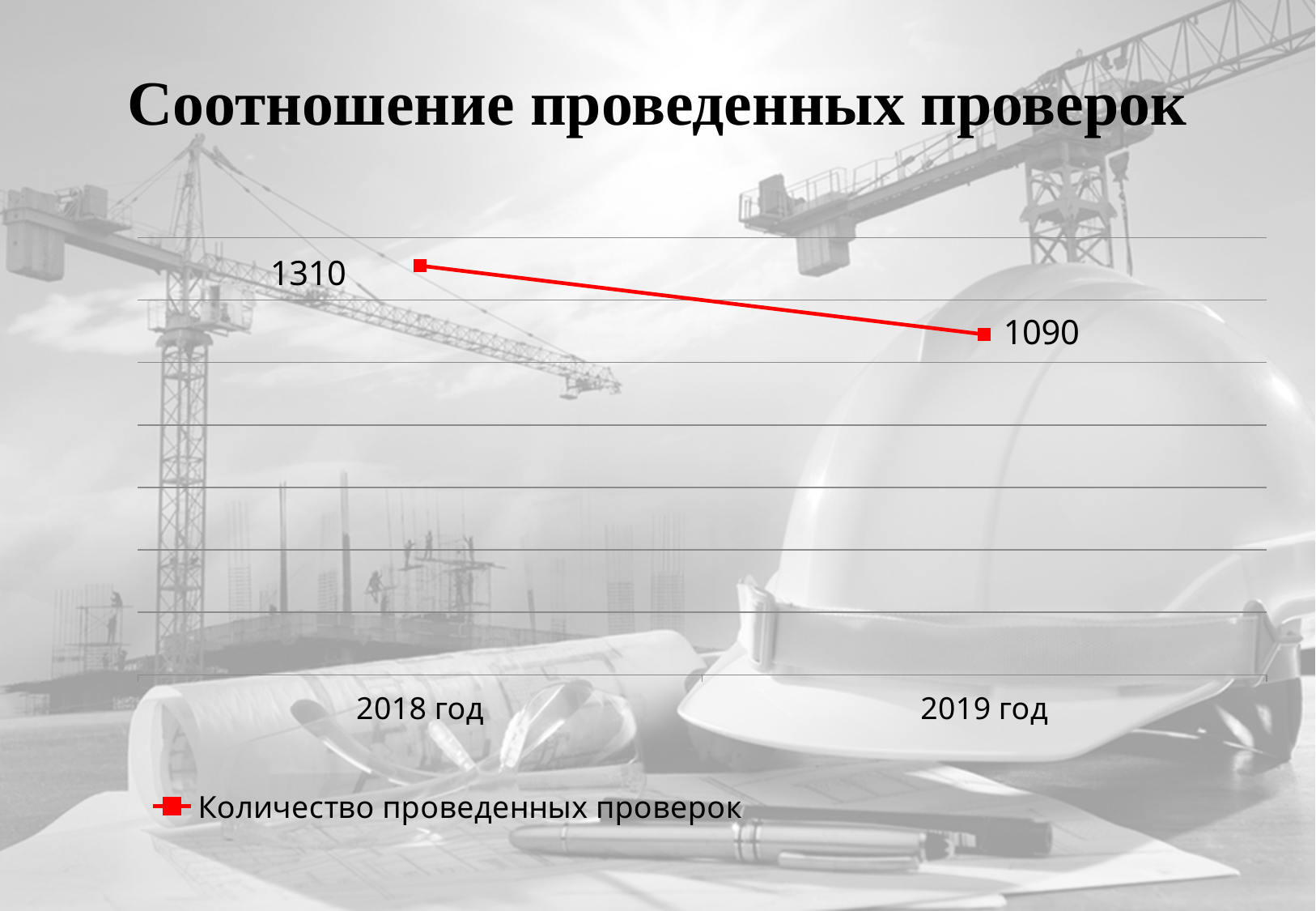
What is the number of inspections conducted in 2019 год? 1090 What is the name of the series in the legend? Количество проведенных проверок Which year has the lower number of inspections conducted? 2019 год How many categories are shown on the x axis? 2 What is the number of inspections conducted in 2018 год? 1310 What is the title of the chart? Соотношение проведенных проверок How many series does the legend list? 1 What kind of chart is shown on the slide? line chart Which year has the higher number of inspections conducted? 2018 год Is the value for 2018 год larger or smaller than the value for 2019 год? larger Do the values rise or fall from 2018 год to 2019 год? fall What is the difference between the number of inspections in 2018 год and 2019 год? 220